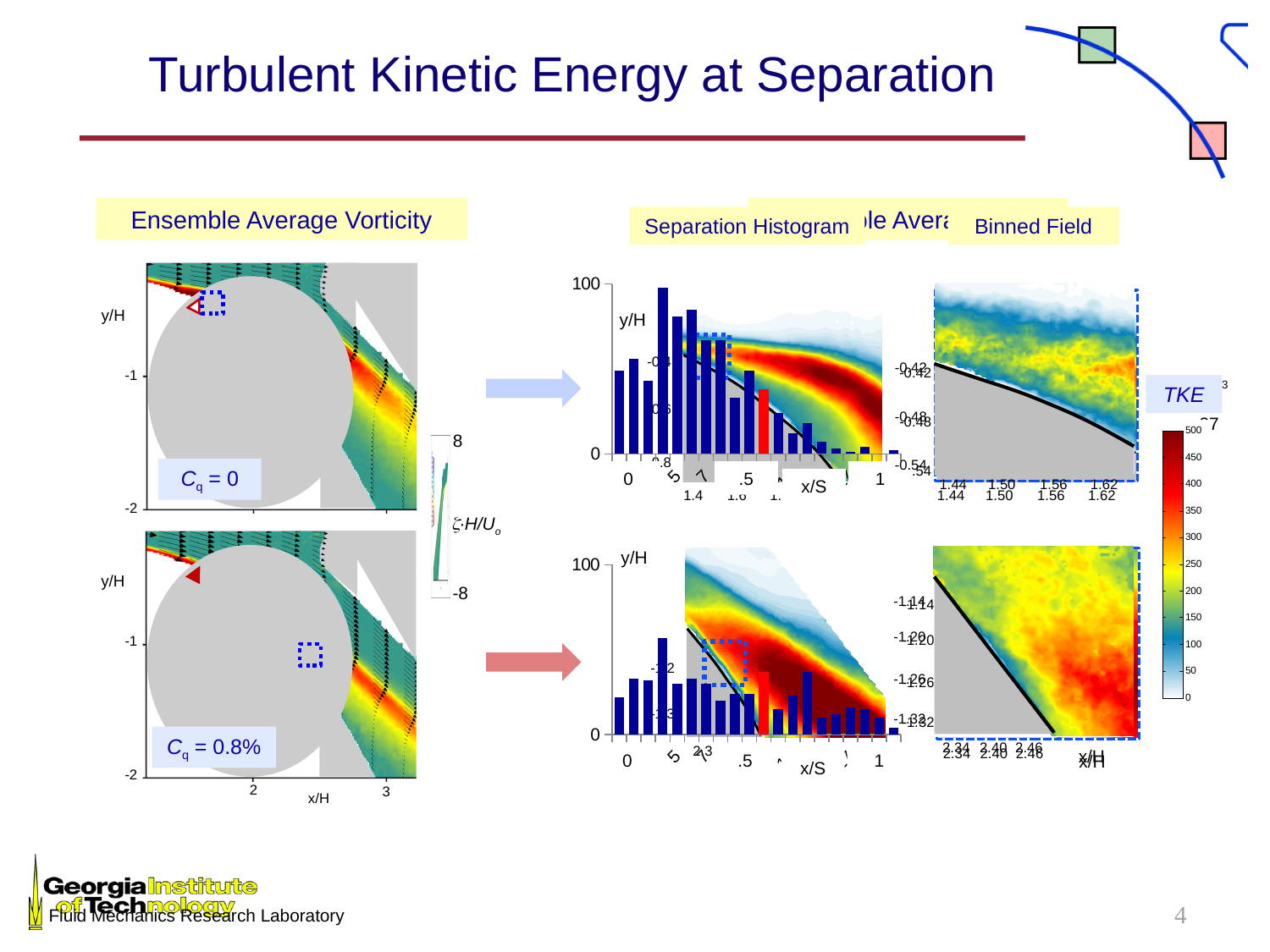
What is the lowest value on the TKE colour scale? 0 What is the maximum value shown on the y axis of the top Separation Histogram? 100 In the top Separation Histogram, is the tallest bar greater or less than 50? greater What is the value of C_q for the lower Ensemble Average Vorticity panel? 0.8% What is the x-axis label of the Separation Histogram charts? x/S What kind of chart is the Separation Histogram? bar chart What is the highest value on the TKE colour scale? 500 What is the value of C_q for the upper Ensemble Average Vorticity panel? 0 Which Separation Histogram, top or bottom, has the taller tallest bar? top